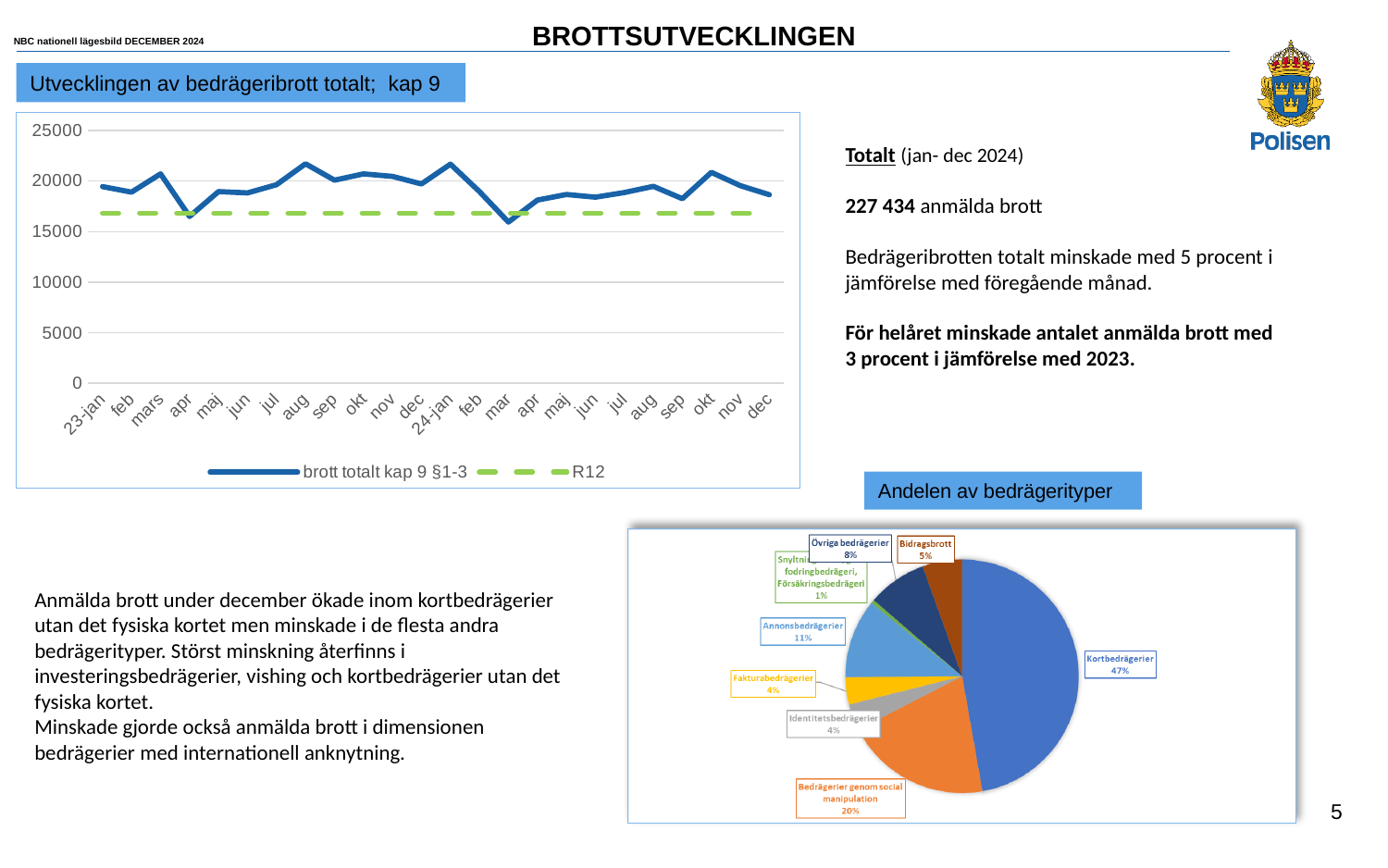
In the pie chart 'Andelen av bedrägerityper', which fraud type has the largest share? Kortbedrägerier In the pie chart 'Andelen av bedrägerityper', what share is Bedrägerier genom social manipulation? 20% In the pie chart 'Andelen av bedrägerityper', what share is Kortbedrägerier? 47% How many series does the legend of the chart 'Utvecklingen av bedrägeribrott totalt; kap 9' list? 2 In the pie chart 'Andelen av bedrägerityper', what share is Bidragsbrott? 5% In the pie chart 'Andelen av bedrägerityper', how many slices are there? 8 In the pie chart 'Andelen av bedrägerityper', which is larger: Övriga bedrägerier or Bidragsbrott? Övriga bedrägerier In the pie chart 'Andelen av bedrägerityper', what share is Annonsbedrägerier? 11% In the pie chart 'Andelen av bedrägerityper', how many percentage points larger is Kortbedrägerier than Bedrägerier genom social manipulation? 27 percentage points In the chart 'Utvecklingen av bedrägeribrott totalt; kap 9', is the value of 'brott totalt kap 9 §1-3' for mar (2024) greater or less than 20000? less What kind of chart is 'Utvecklingen av bedrägeribrott totalt; kap 9'? Line chart In the chart 'Utvecklingen av bedrägeribrott totalt; kap 9', is the value of 'brott totalt kap 9 §1-3' for aug (2023) greater or less than 20000? greater